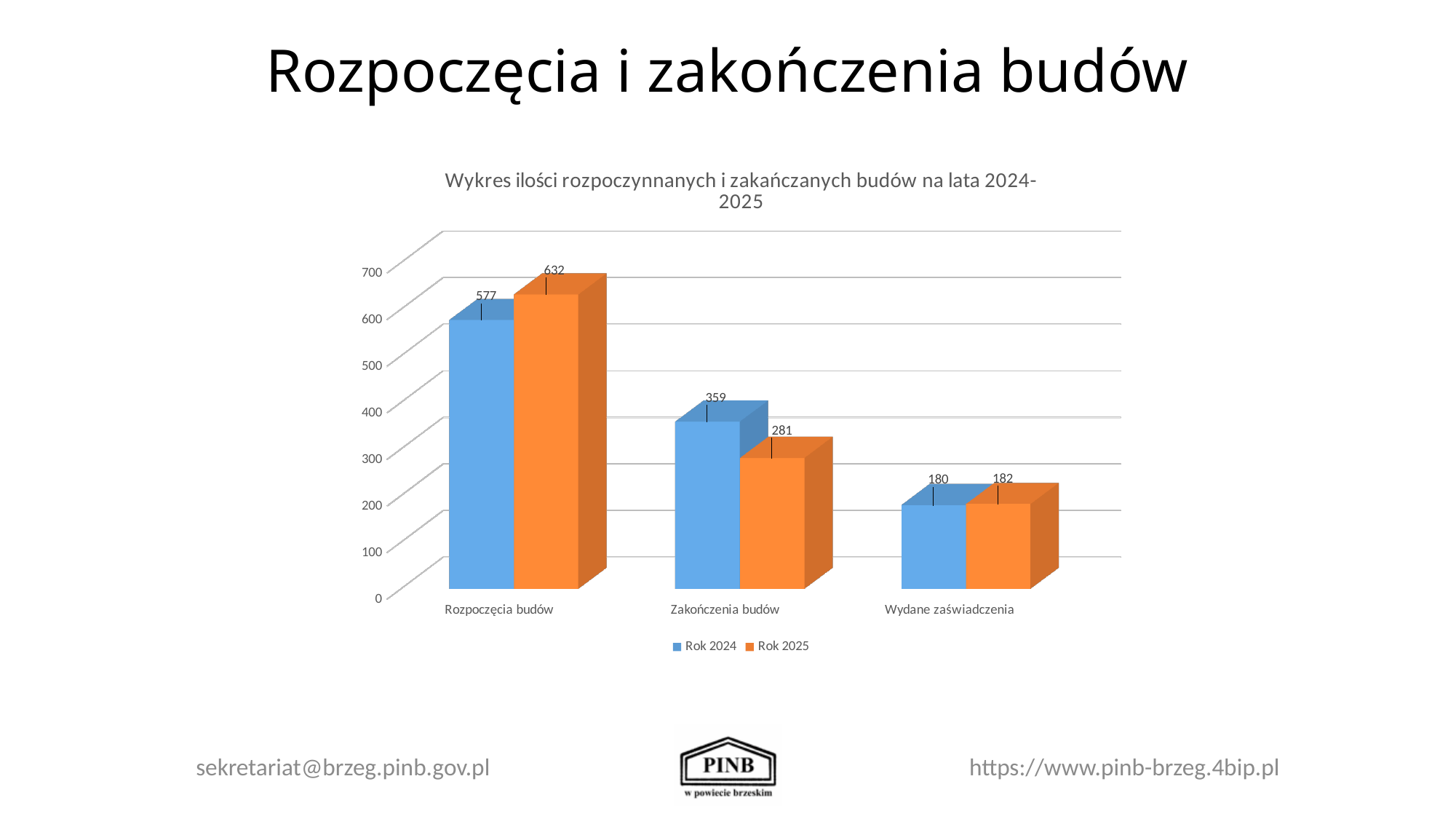
What is the difference between the Rok 2025 and Rok 2024 values for Rozpoczęcia budów? 55 What is the value for Rok 2024 in the Zakończenia budów category? 359 How many categories are shown on the x axis? 3 What is the difference between the Rok 2024 and Rok 2025 values for Zakończenia budów? 78 Which is larger for Zakończenia budów: Rok 2024 or Rok 2025? Rok 2024 What is the value for Rok 2025 in the Wydane zaświadczenia category? 182 What is the value for Rok 2025 in the Rozpoczęcia budów category? 632 Which category has the lowest value for Rok 2024? Wydane zaświadczenia How many series does the legend list? 2 What kind of chart is shown on the slide? Bar chart What is the value for Rok 2024 in the Rozpoczęcia budów category? 577 Which category has the highest value for Rok 2025? Rozpoczęcia budów